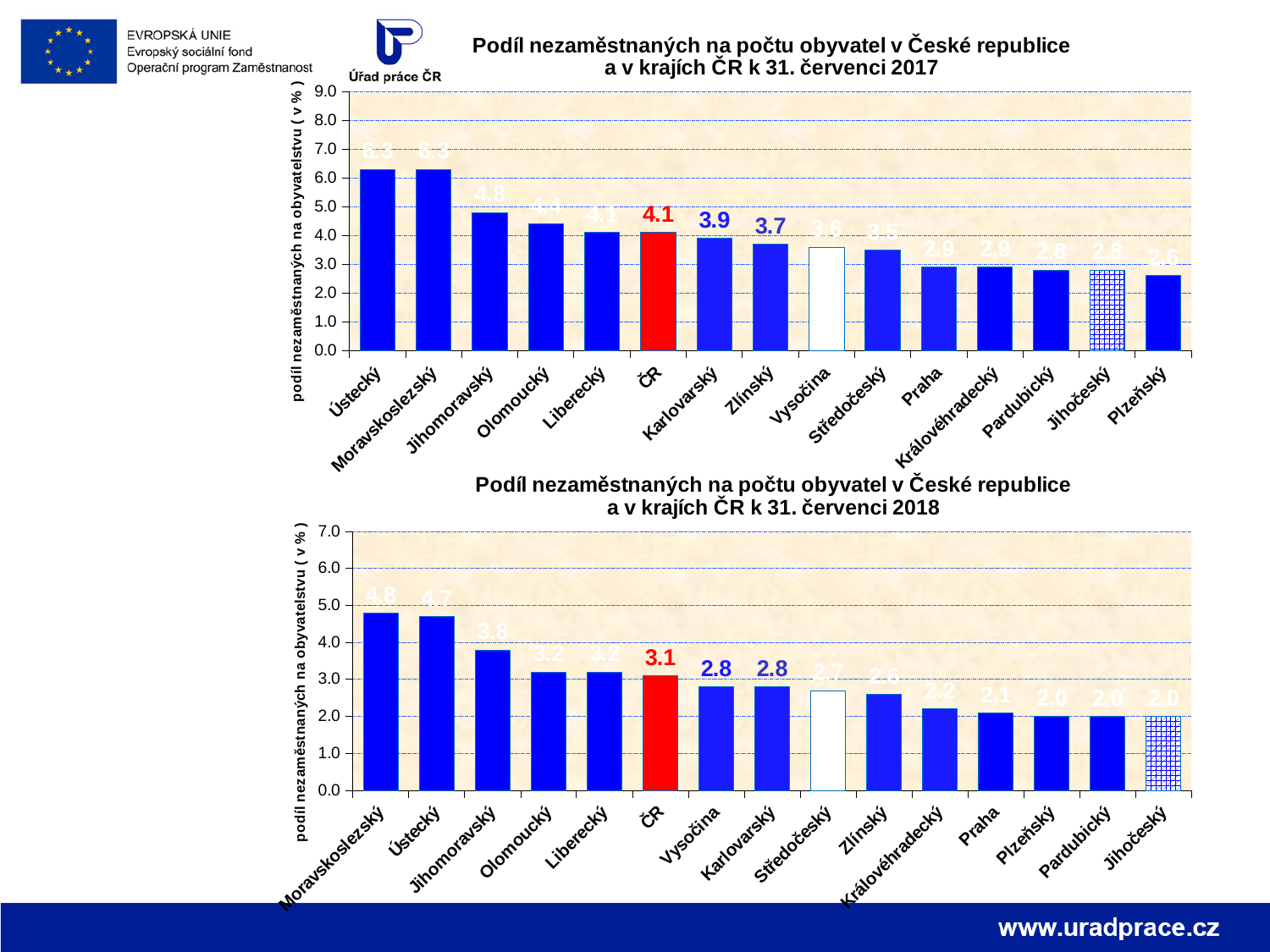
In the top chart (2017), what is the value for ČR? 4.1 In the top chart (2017), is the value for Ústecký greater or less than 6.0? greater In the bottom chart (2018), is the value for Moravskoslezský greater or less than 4.0? greater What kind of chart is the bottom chart (2018)? bar chart In the bottom chart (2018), what is the value for Vysočina? 2.8 In the top chart (2017), what is the difference between the values for ČR and Karlovarský? 0.2 In the top chart (2017), what is the value for Karlovarský? 3.9 How many bars are plotted in the top chart (2017)? 15 In the bottom chart (2018), do the values generally rise or fall from left to right? fall In the top chart (2017), which is larger, the value for Karlovarský or for Zlínský? Karlovarský In the top chart (2017), what is the value for Zlínský? 3.7 In the bottom chart (2018), what is the value for ČR? 3.1